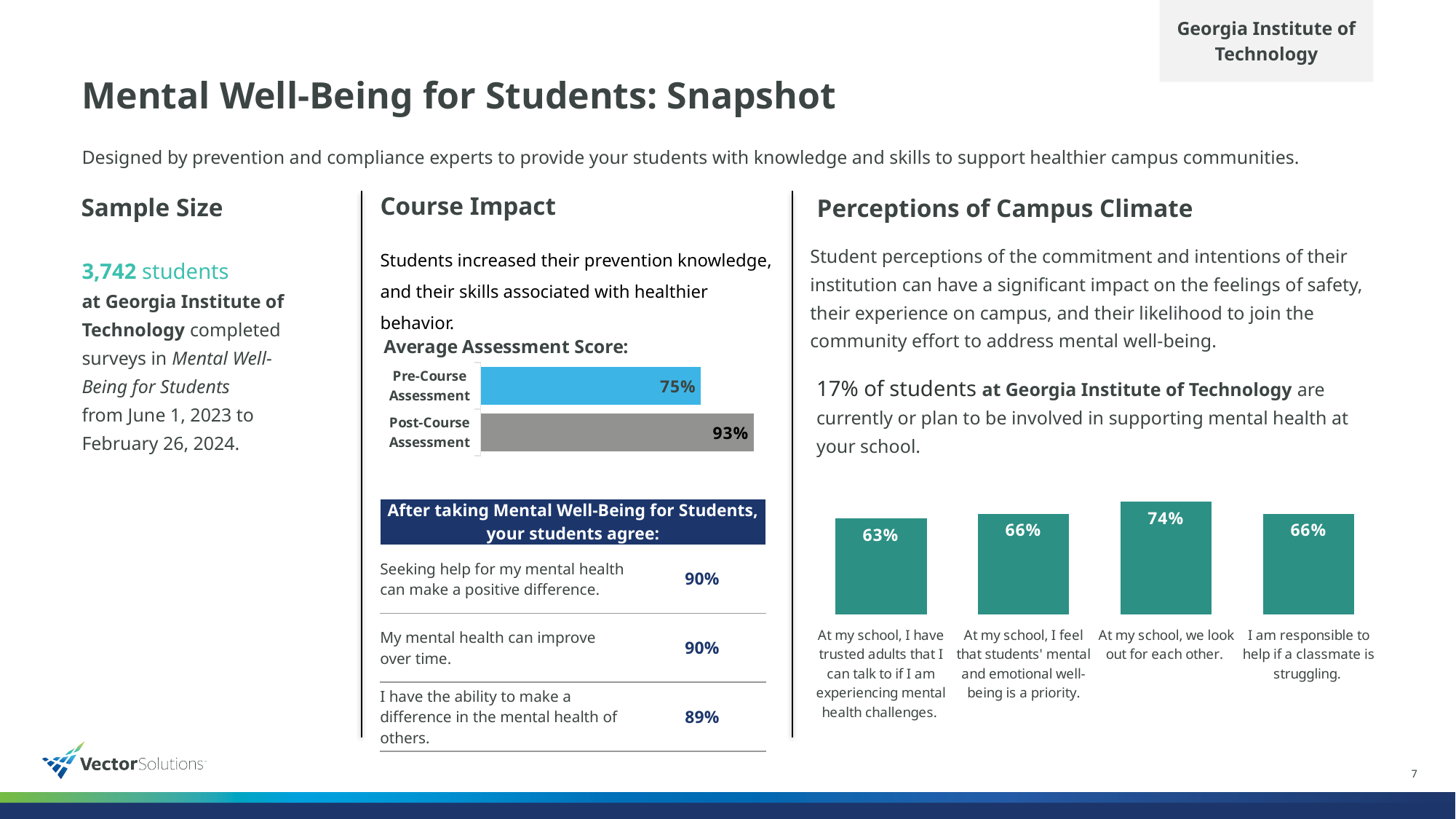
In the Average Assessment Score chart, what is the difference between the Post-Course and Pre-Course Assessment values? 18% In the Perceptions of Campus Climate chart, which statement has the lowest percentage? At my school, I have trusted adults that I can talk to if I am experiencing mental health challenges. In the Average Assessment Score chart, what is the Post-Course Assessment value? 93% In the Perceptions of Campus Climate chart, what is the difference between the 'we look out for each other' value and the 'trusted adults' value? 11% In the Average Assessment Score chart, what is the Pre-Course Assessment value? 75% In the Perceptions of Campus Climate chart, what percentage of students agree 'At my school, I have trusted adults that I can talk to if I am experiencing mental health challenges'? 63% In the Average Assessment Score chart, which assessment has the higher value, Pre-Course or Post-Course? Post-Course Assessment In the Perceptions of Campus Climate chart, what percentage of students agree 'At my school, we look out for each other'? 74% In the Perceptions of Campus Climate chart, how many bars are shown? 4 What kind of chart is the Average Assessment Score chart? Bar chart In the Perceptions of Campus Climate chart, which statement has the highest percentage? At my school, we look out for each other. In the Average Assessment Score chart, how many bars are shown? 2